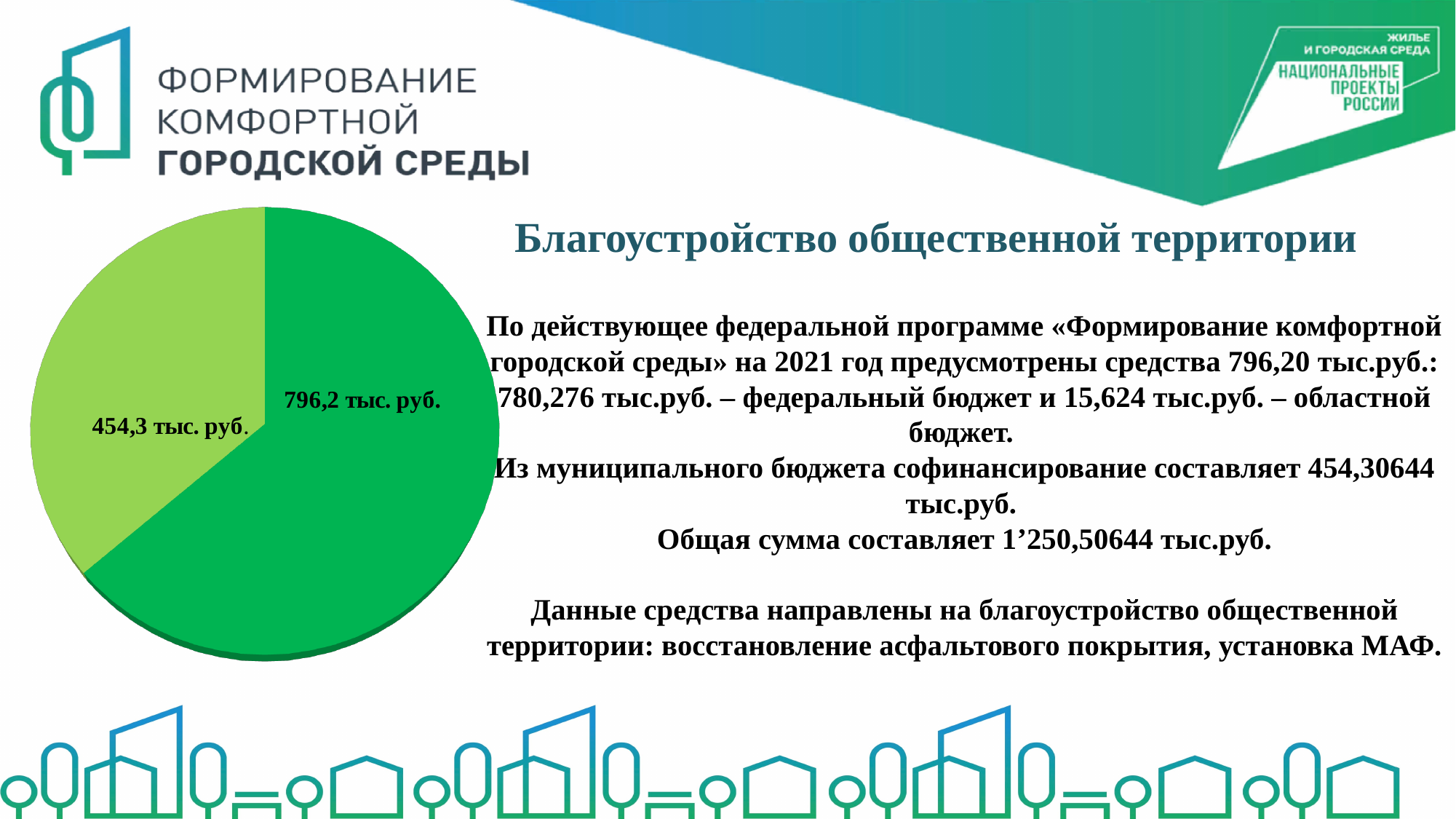
What is the difference between the two values shown in the pie chart? 341,9 тыс. руб. What is the title of the text block next to the pie chart? Благоустройство общественной территории What value is labelled on the dark green slice of the pie chart? 796,2 тыс. руб. Does the dark green slice take up more or less than half of the pie chart? more Does the pie chart have a legend? No What value is labelled on the light green slice of the pie chart? 454,3 тыс. руб. What is the total of the two values labelled in the pie chart? 1250,5 тыс. руб. How many slices does the pie chart have? 2 Which slice of the pie chart has the largest value? the dark green slice (796,2 тыс. руб.) Which is larger in the pie chart: the dark green slice or the light green slice? the dark green slice What kind of chart is shown on the left of the slide? pie chart Which slice of the pie chart has the smallest value? the light green slice (454,3 тыс. руб.)